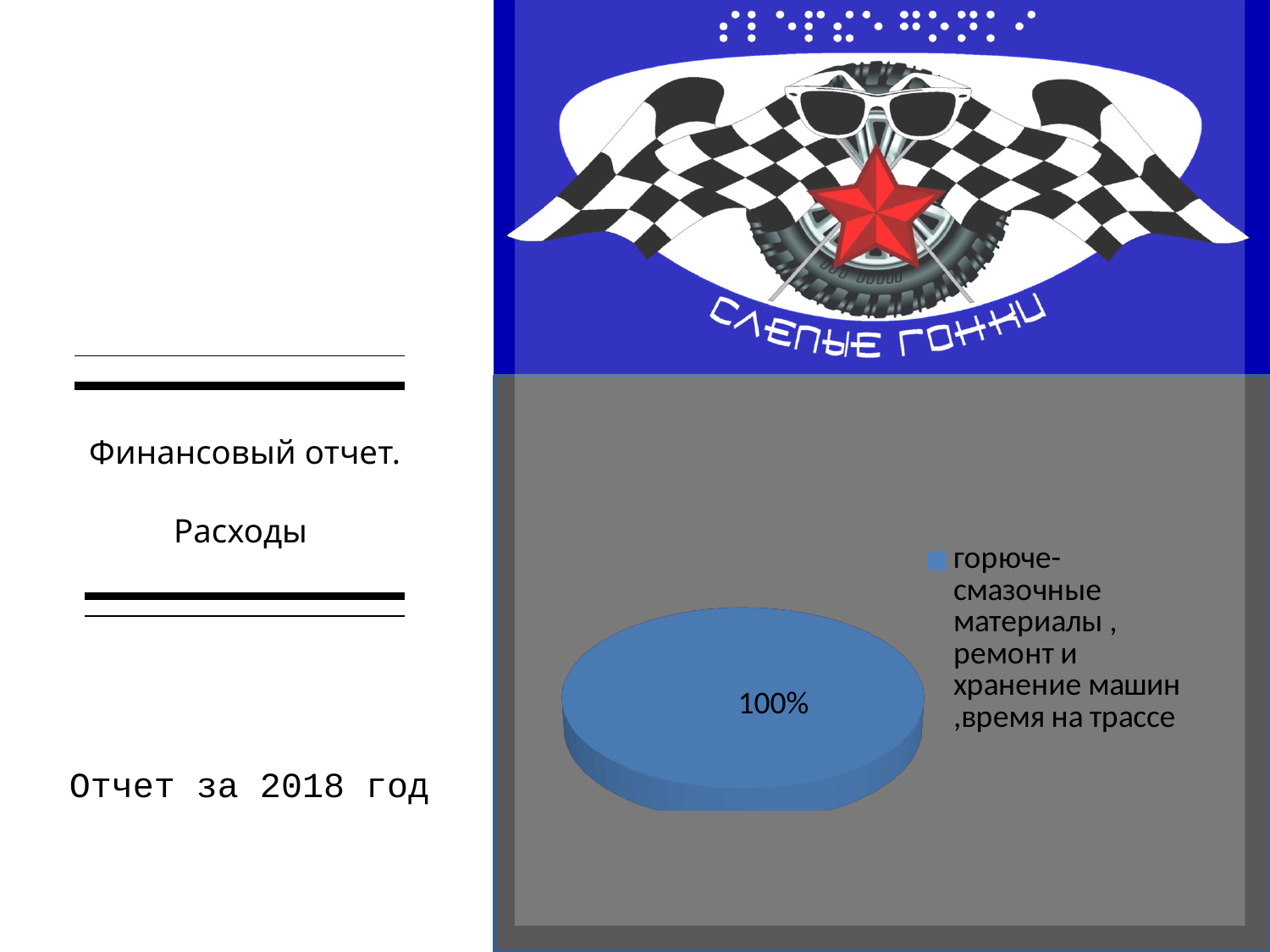
How many slices does the pie chart have? 1 What share of the pie does the slice for "горюче-смазочные материалы, ремонт и хранение машин, время на трассе" represent? 100% What colour is the single slice of the pie chart? blue What kind of chart is shown on the slide? pie chart What is the legend entry of the pie chart? горюче-смазочные материалы , ремонт и хранение машин ,время на трассе Is the value shown on the pie chart greater or less than 50%? greater What value is printed as the data label on the pie chart? 100% How many entries does the legend of the pie chart list? 1